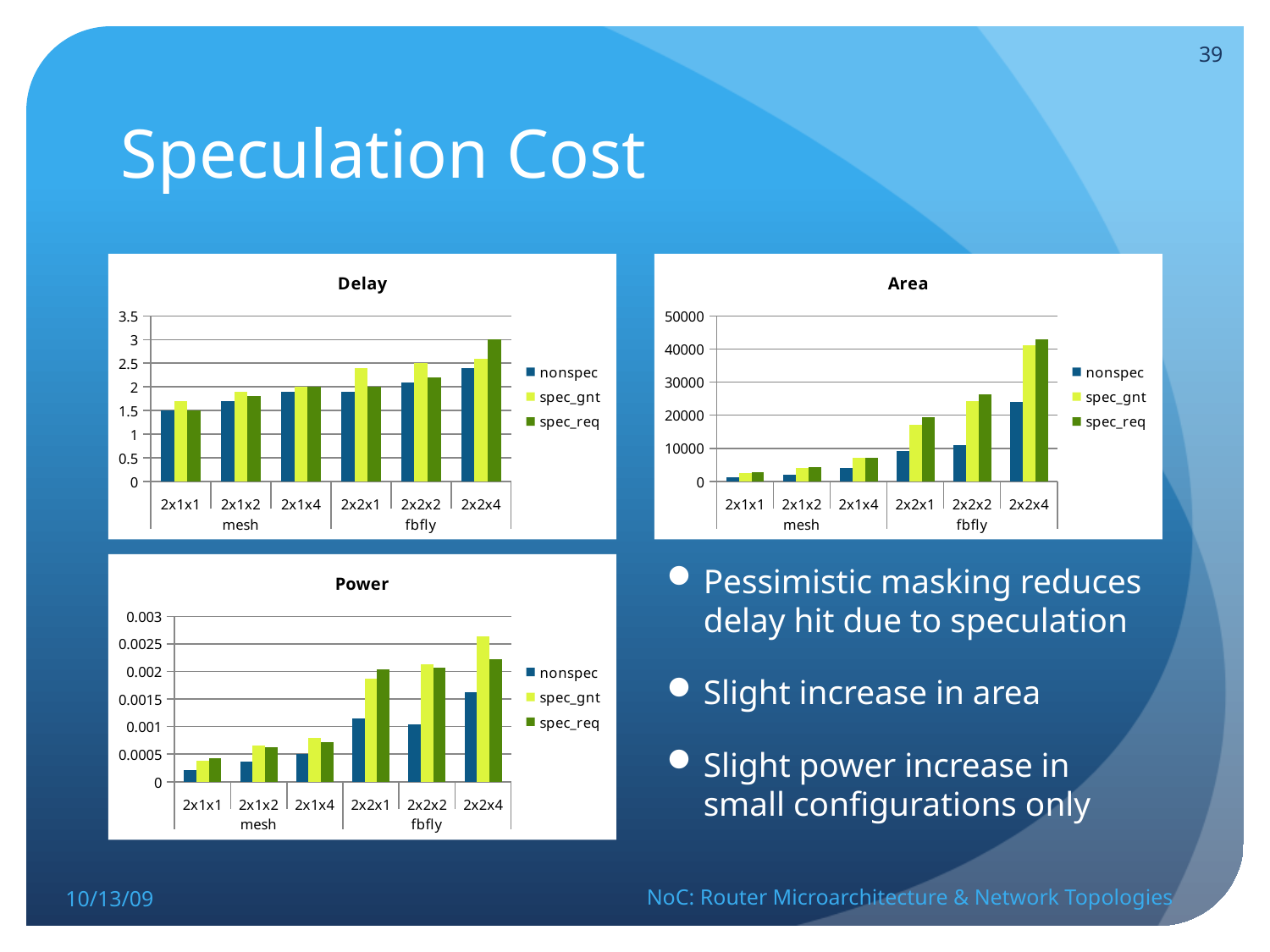
In the Delay chart, which configuration has the highest spec_req value? 2x2x4 In the Power chart, is the nonspec value for 2x1x1 greater or less than 0.0005? less How many configuration categories are shown on the x axis of the Power chart? 6 What are the two topology groups labelled under the x axis of the Delay chart? mesh and fbfly How many series does the legend of the Area chart list? 3 What kind of chart is the Delay chart? bar chart In the Area chart, is the spec_req value for 2x2x4 greater or less than 40000? greater In the Area chart, for 2x2x4, which is larger: nonspec or spec_gnt? spec_gnt In the Power chart, which configuration has the highest spec_gnt value? 2x2x4 In the Area chart, do the nonspec values rise or fall from 2x1x1 to 2x2x4 along the x axis? rise In the Area chart, which configuration has the lowest nonspec value? 2x1x1 In the Delay chart, is the spec_req value for 2x2x4 greater or less than 2.5? greater